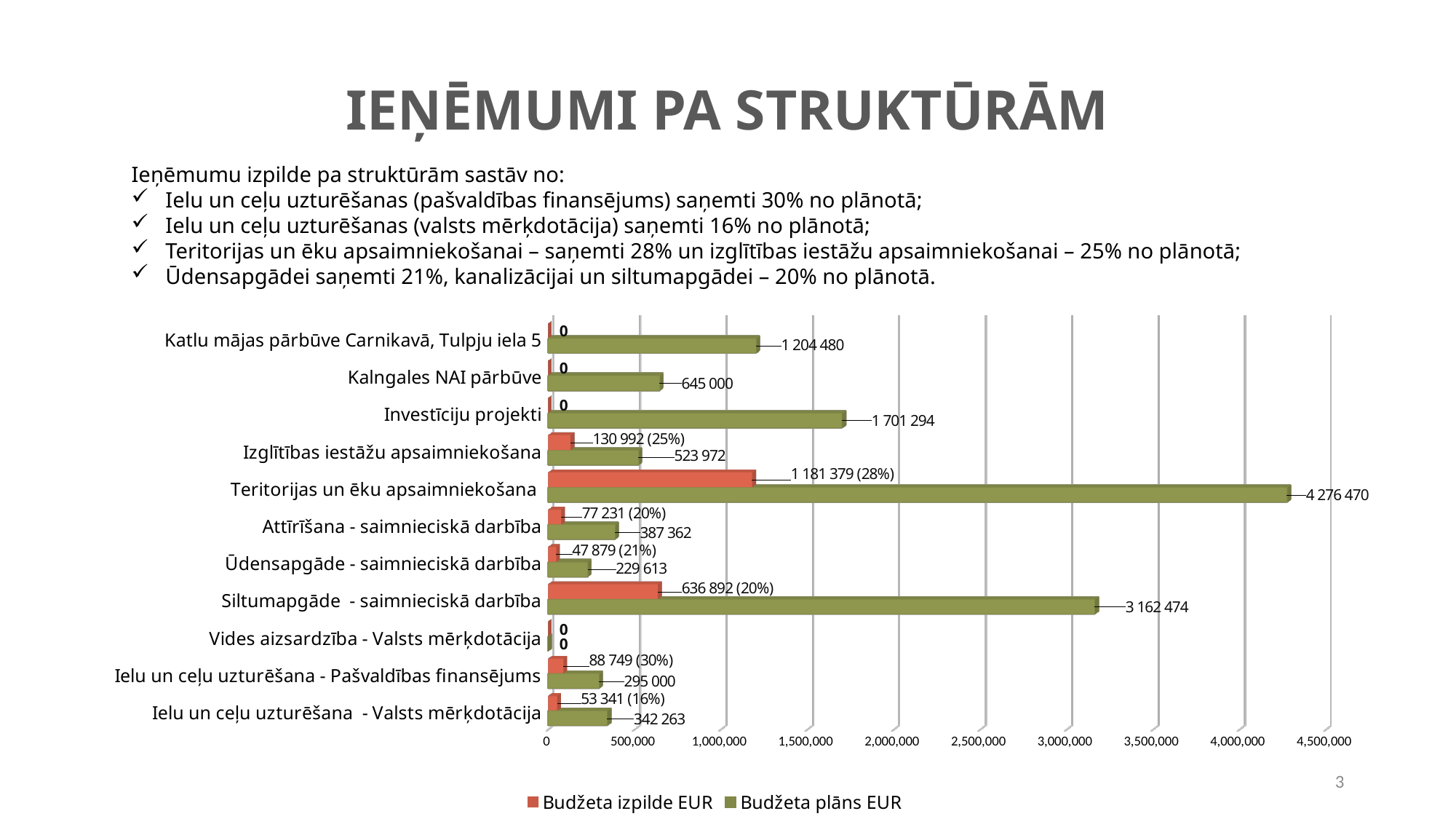
What is the difference between the Budžeta plāns EUR and Budžeta izpilde EUR values for Siltumapgāde - saimnieciskā darbība? 2 525 582 What is the Budžeta plāns EUR value for Teritorijas un ēku apsaimniekošana? 4 276 470 What is the Budžeta izpilde EUR value for Siltumapgāde - saimnieciskā darbība? 636 892 (20%) Which category has the highest Budžeta plāns EUR value? Teritorijas un ēku apsaimniekošana How many categories are shown on the chart? 11 What is the Budžeta plāns EUR value for Kalngales NAI pārbūve? 645 000 What kind of chart is shown on the slide? Bar chart How many series does the legend list? 2 Which is larger: the Budžeta plāns EUR value for Investīciju projekti or for Katlu mājas pārbūve Carnikavā, Tulpju iela 5? Investīciju projekti What is the Budžeta izpilde EUR value for Ielu un ceļu uzturēšana - Valsts mērķdotācija? 53 341 (16%) Is the Budžeta plāns EUR value for Siltumapgāde - saimnieciskā darbība greater or less than 3,000,000? greater Which category has the highest Budžeta izpilde EUR value? Teritorijas un ēku apsaimniekošana